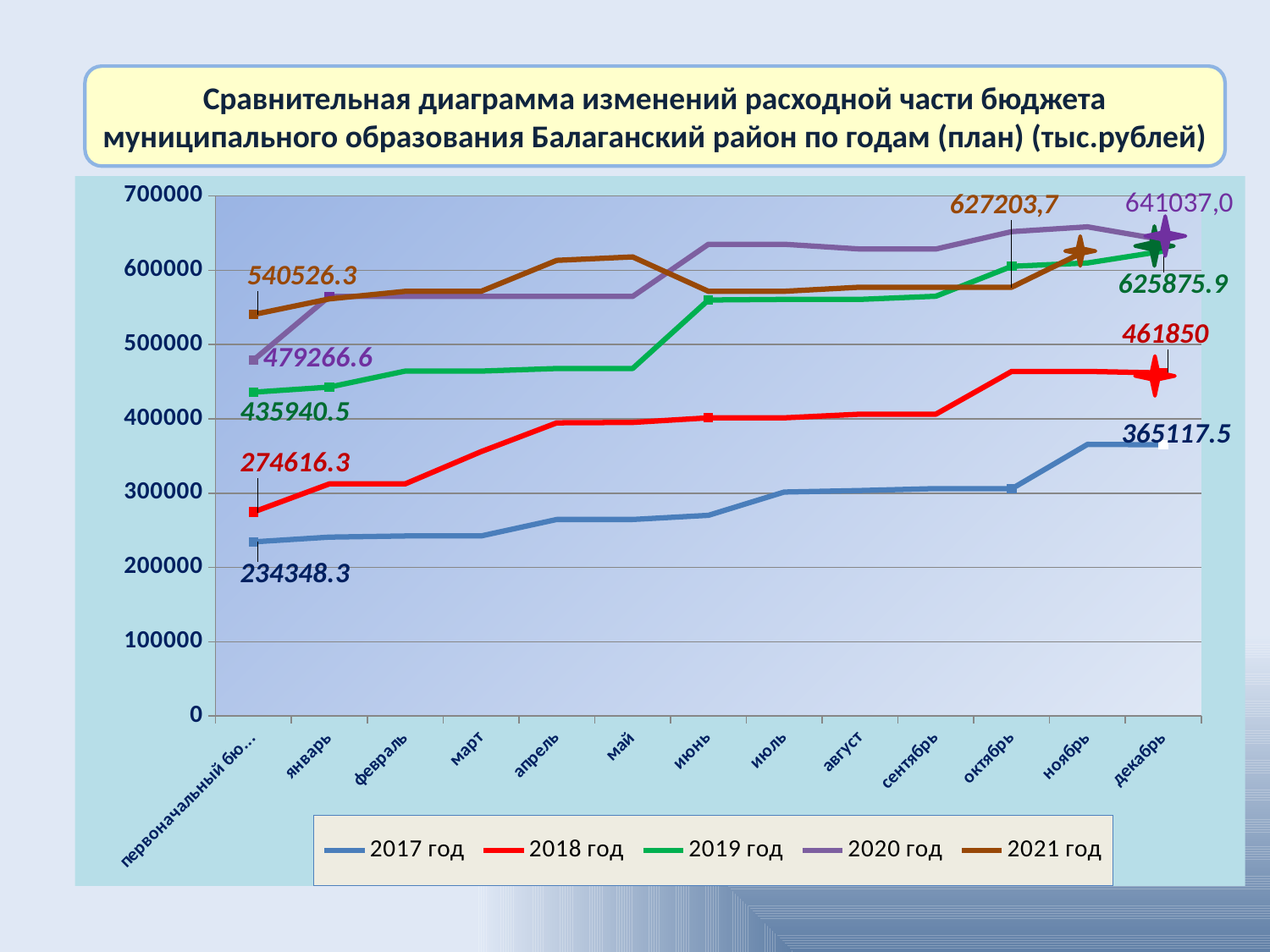
Which series has the lowest value at the first category (первоначальный бюджет)? 2017 год At декабрь, which series has the larger value: 2020 год or 2019 год? 2020 год How many categories are shown along the x axis? 13 Is the value for 2017 год at июнь greater or less than 300000? less What is the labelled value for 2021 год at the first category (первоначальный бюджет)? 540526.3 What is the labelled value for 2020 год at декабрь? 641037,0 What is the labelled value for 2017 год at the first category (первоначальный бюджет)? 234348.3 What is the labelled value for 2018 год at декабрь? 461850 How many series does the legend list? 5 What is the labelled value for 2019 год at декабрь? 625875.9 By how much does the 2017 год value at декабрь (365117.5) exceed its value at the first category (234348.3)? 130769.2 What kind of chart is shown on the slide? line chart